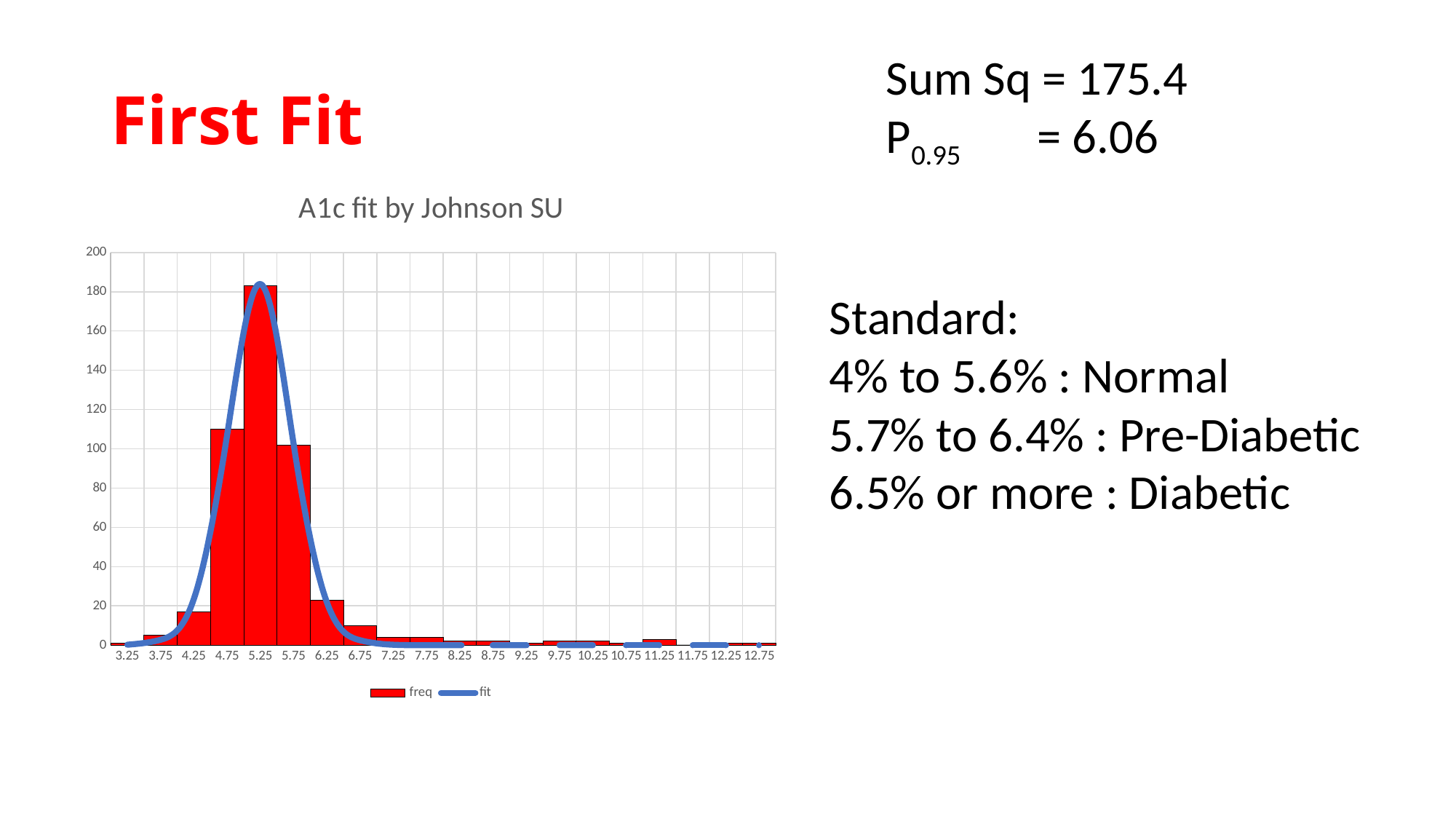
Is the freq value for 5.25 greater or less than 160? greater How many series does the chart legend list? 2 Which has a larger freq value, 4.75 or 6.25? 4.75 Do the freq values rise or fall along the x axis from 5.25 to 7.25? fall What is the title of the chart? A1c fit by Johnson SU How many categories are shown on the x axis of the chart? 20 What kind of chart is shown on the slide? A bar chart (histogram) with a fitted line overlay What are the two entries in the chart legend? freq and fit Is the freq value for 5.75 greater or less than 120? less Is the freq value for 4.75 greater or less than 100? greater Which x-axis category has the highest freq bar? 5.25